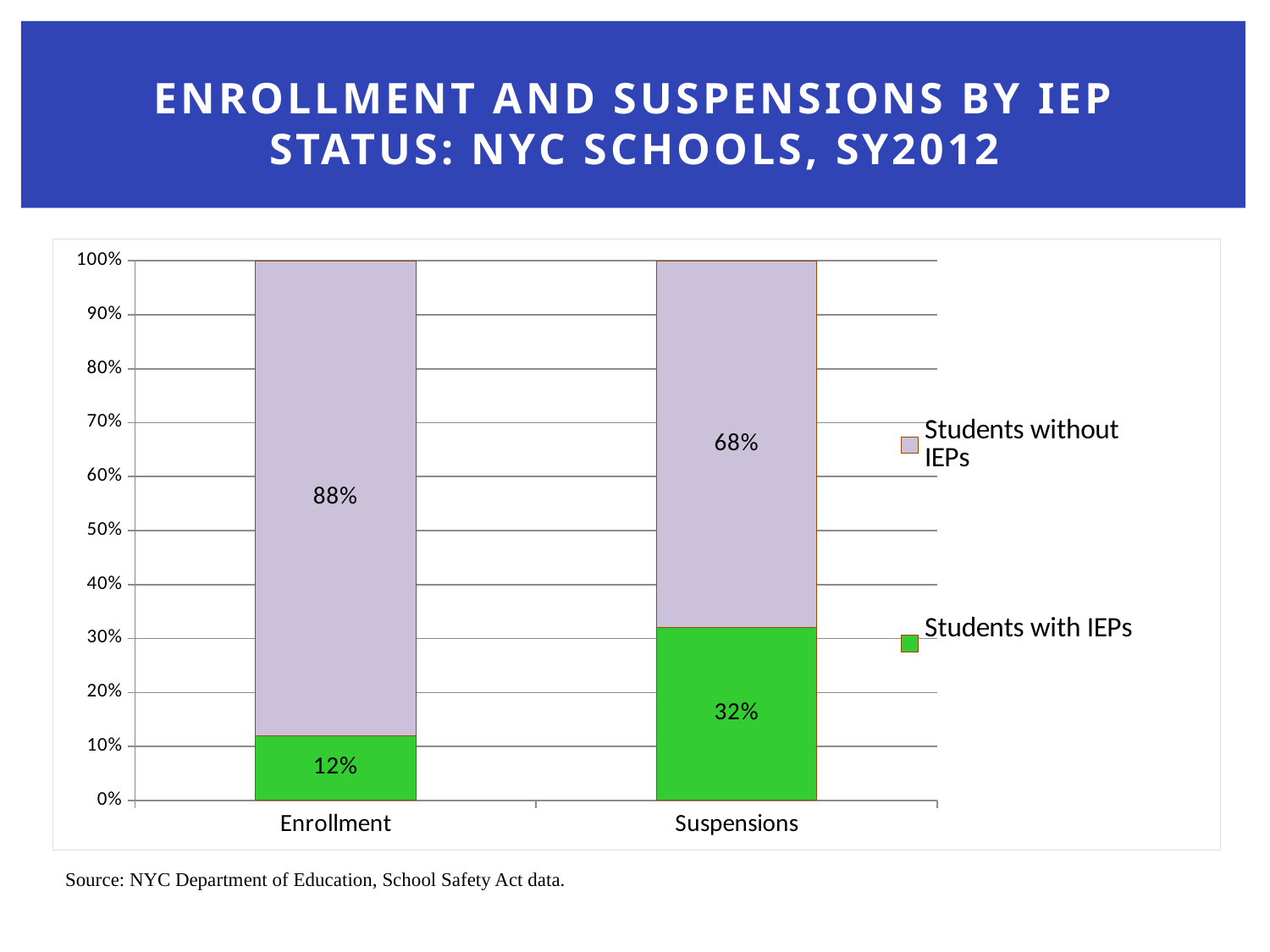
What is the difference between the Students with IEPs share for Suspensions and for Enrollment? 20% Which colour represents Students with IEPs? Green What kind of chart is shown on the slide? Stacked bar chart What is the difference between the Students without IEPs share for Enrollment and for Suspensions? 20% What percentage of Suspensions is Students without IEPs? 68% How many categories are shown on the x axis? 2 What percentage of Suspensions is Students with IEPs? 32% Which category has the higher share of Students with IEPs, Enrollment or Suspensions? Suspensions What percentage of Enrollment is Students with IEPs? 12% How many series does the legend list? 2 What is the total of the Enrollment stacked bar? 100% What percentage of Enrollment is Students without IEPs? 88%